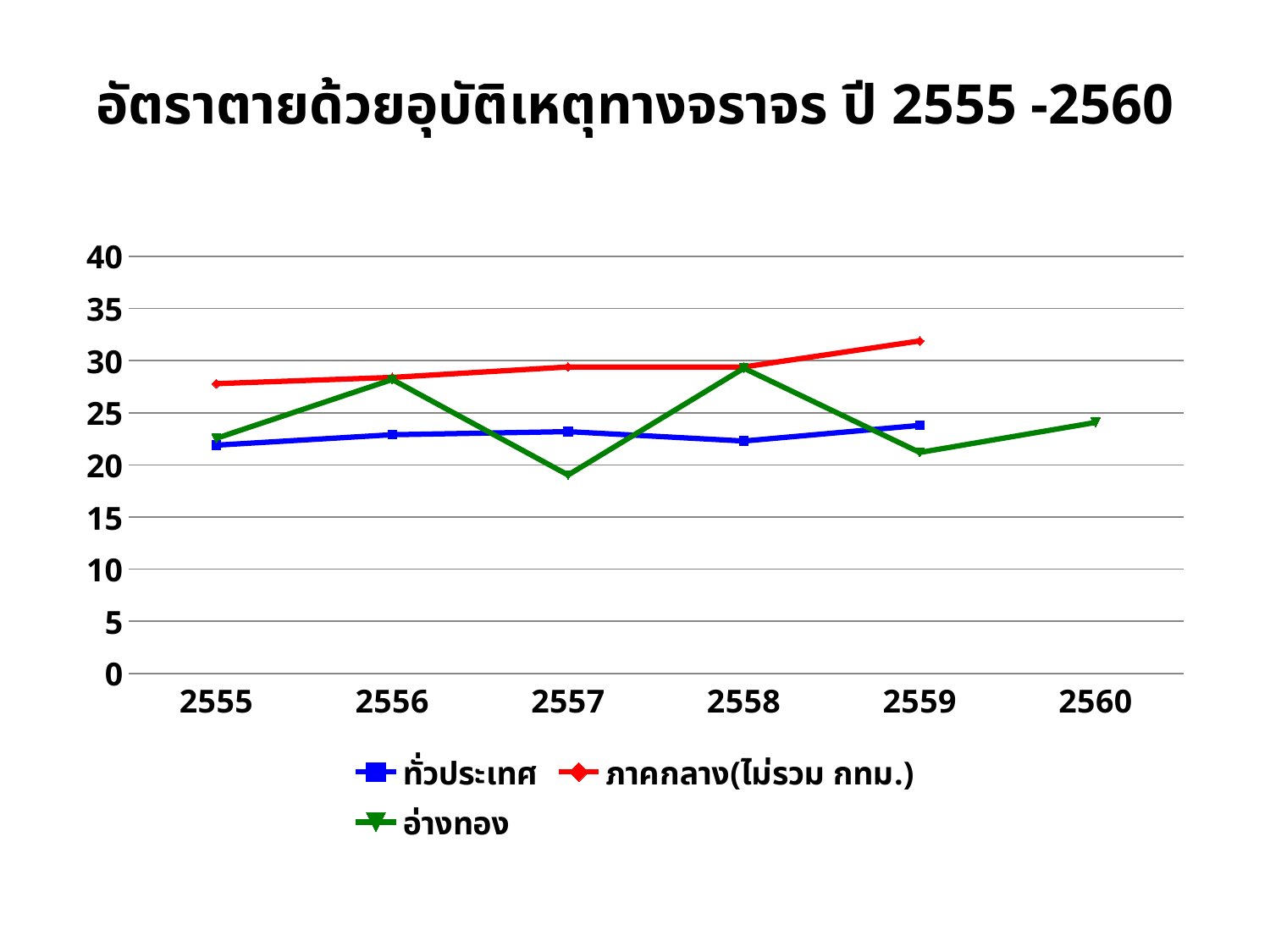
What colour is the line for อ่างทอง? green In which year is the value for อ่างทอง lowest? 2557 How many series does the legend list? 3 Does the ภาคกลาง(ไม่รวม กทม.) line rise or fall from 2555 to 2559? rise Is the value for ภาคกลาง(ไม่รวม กทม.) in 2559 greater or less than 30? greater Is the value for อ่างทอง in 2557 greater or less than 20? less What kind of chart is shown on the slide? line chart Which series has the highest value in 2559? ภาคกลาง(ไม่รวม กทม.) Is the value for ทั่วประเทศ in 2555 greater or less than 25? less In 2556, which is larger: อ่างทอง or ทั่วประเทศ? อ่างทอง In 2557, which is larger: ภาคกลาง(ไม่รวม กทม.) or อ่างทอง? ภาคกลาง(ไม่รวม กทม.) How many years are shown on the x axis? 6